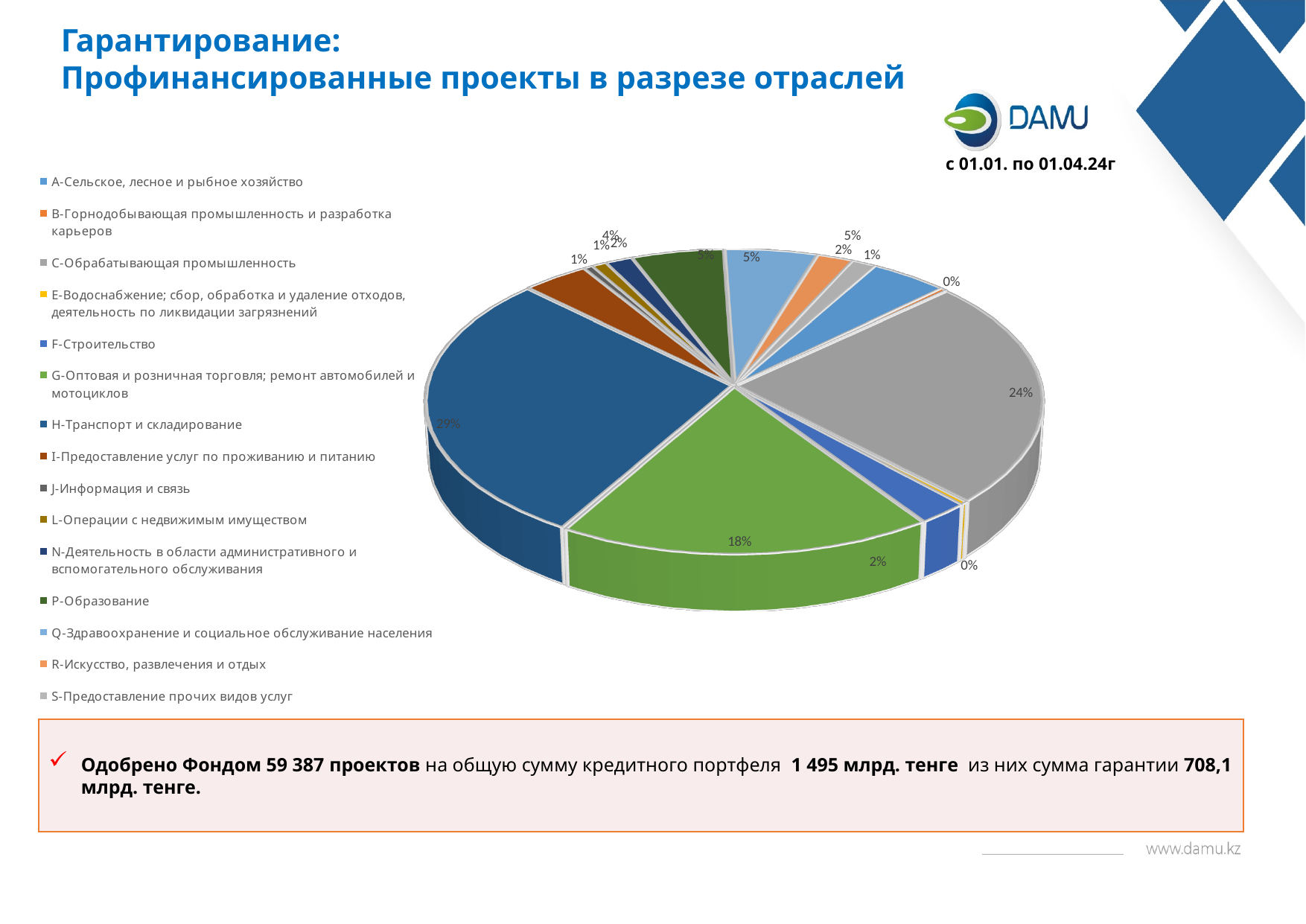
What is the difference in percentage points between the 24% slice and the 18% slice? 6 percentage points What kind of chart is shown on the slide? Pie chart What percentage is labelled on the large green slice of the pie chart? 18% What is the difference in percentage points between the 29% slice and the 24% slice? 5 percentage points What is the combined share of the three largest slices (29%, 24% and 18%)? 71% What is the largest percentage shown on any slice of the pie chart? 29% What reporting period is stated above the pie chart? с 01.01. по 01.04.24г How many industry categories does the legend of the pie chart list? 15 What is the title of the slide containing the pie chart? Гарантирование: Профинансированные проекты в разрезе отраслей What is the smallest percentage value labelled on the pie chart? 0% What is the second-largest percentage labelled on the pie chart? 24% Which is larger: the dark blue slice labelled 29% or the gray slice labelled 24%? The dark blue slice (29%)